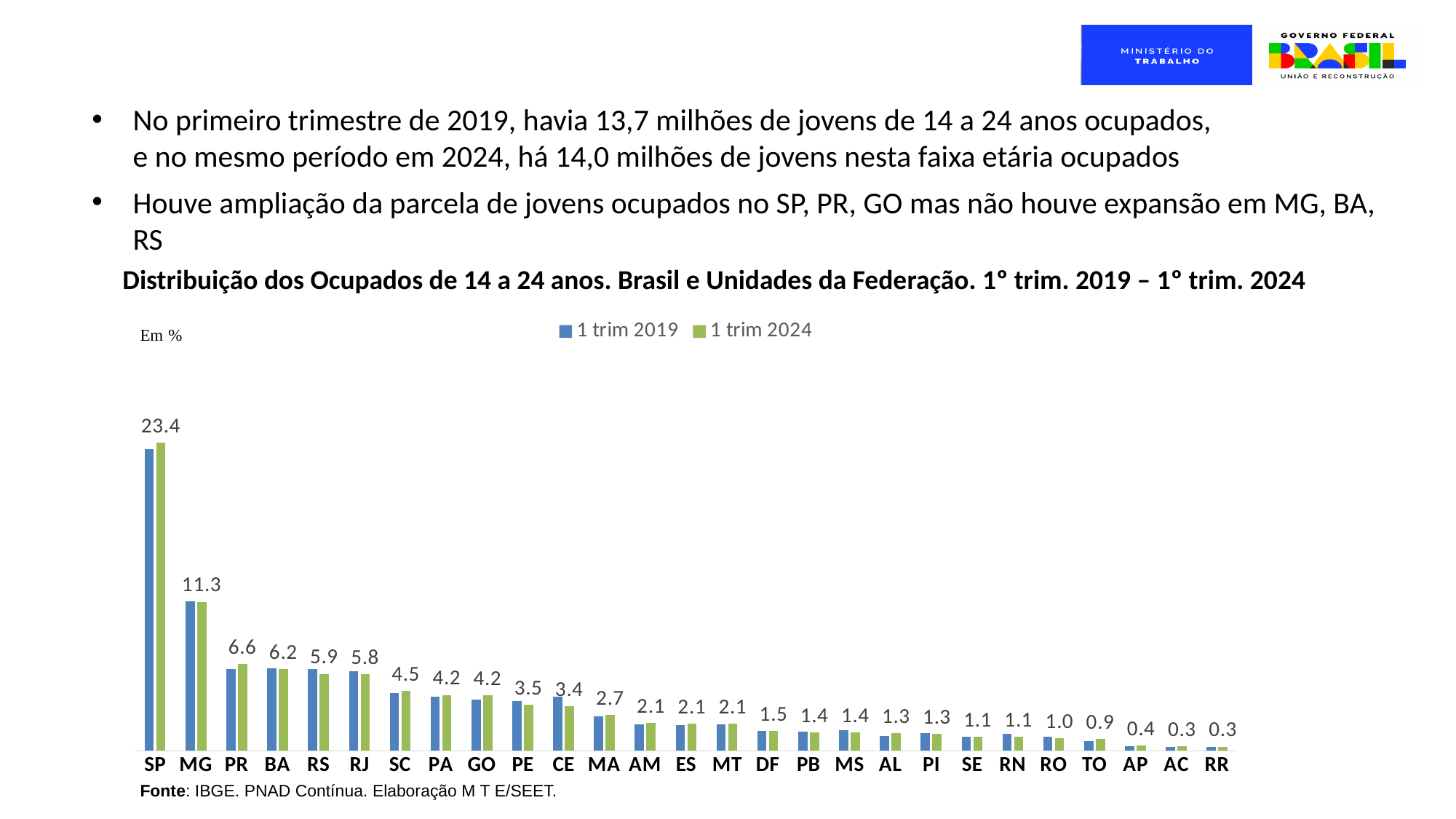
What kind of chart is shown on the slide? bar chart How many series does the chart legend list? 2 What are the two series named in the chart legend? 1 trim 2019 and 1 trim 2024 Do the labelled values rise or fall moving from left to right along the x axis? fall Which state has the highest share of occupied youths aged 14 to 24 in the chart? SP What value is labelled above the bars for MG? 11.3 For SP, which series has the taller bar, 1 trim 2019 or 1 trim 2024? 1 trim 2024 What value is labelled above the bars for SP? 23.4 What is the difference between the labelled values for SP and MG? 12.1 What value is labelled above the bars for PR? 6.6 What value is labelled above the bars for RJ? 5.8 How many states (categories) are shown on the x axis of the chart? 27